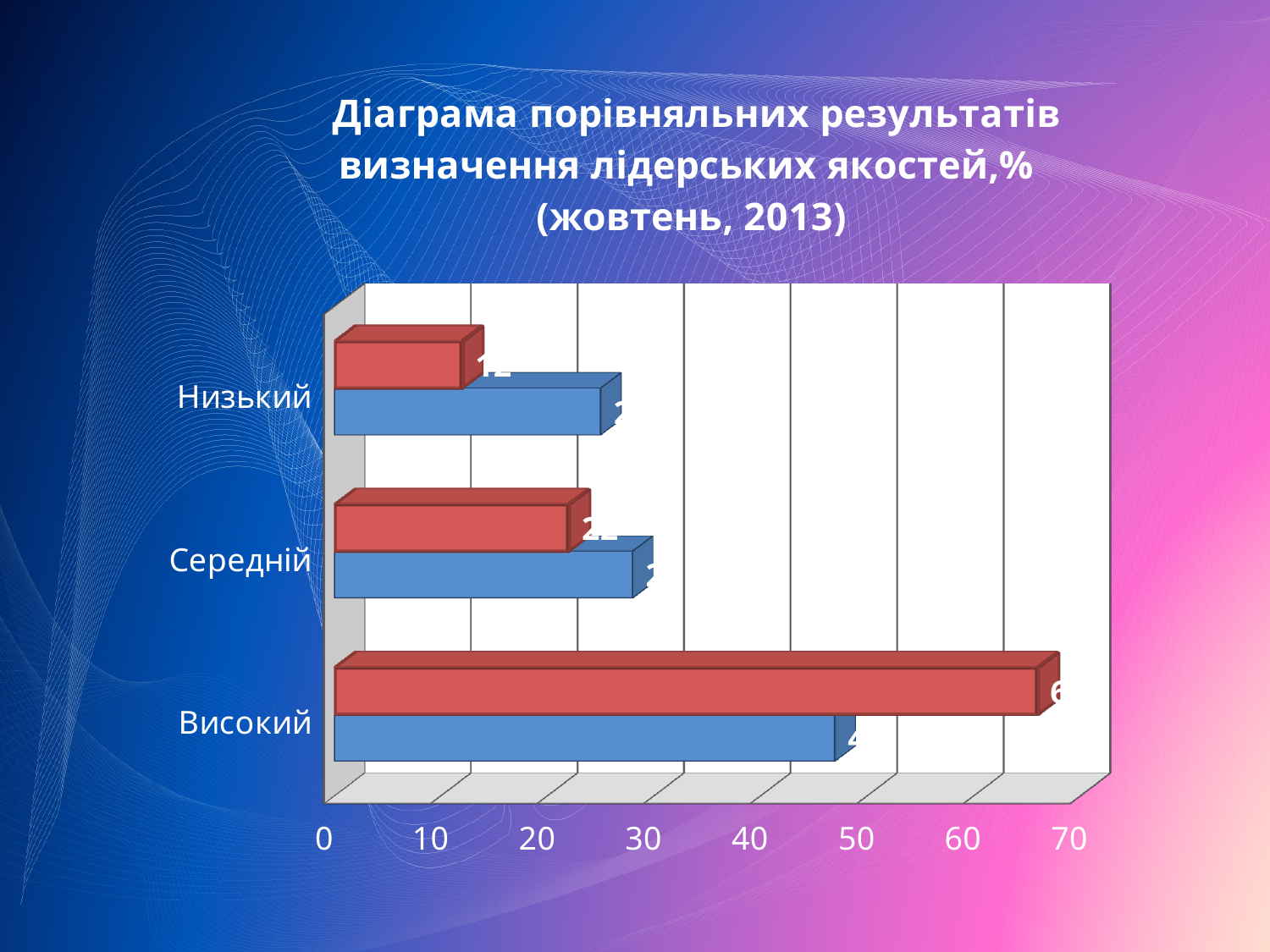
What kind of chart is shown on the slide? bar chart For the category Високий, which bar is longer, the red one or the blue one? red Is the value of the red bar for Низький greater or less than 20? less What is the title of the chart? Діаграма порівняльних результатів визначення лідерських якостей,% (жовтень, 2013) Which category has the shortest red bar? Низький How many categories are shown on the vertical axis of the chart? 3 Is the value of the red bar for Високий greater or less than 60? greater Which category has the longest red bar? Високий What two colours are used for the bars in the chart? red and blue Which category has the longest blue bar? Високий Is the value of the blue bar for Високий greater or less than 40? greater For the category Низький, which bar is longer, the red one or the blue one? blue